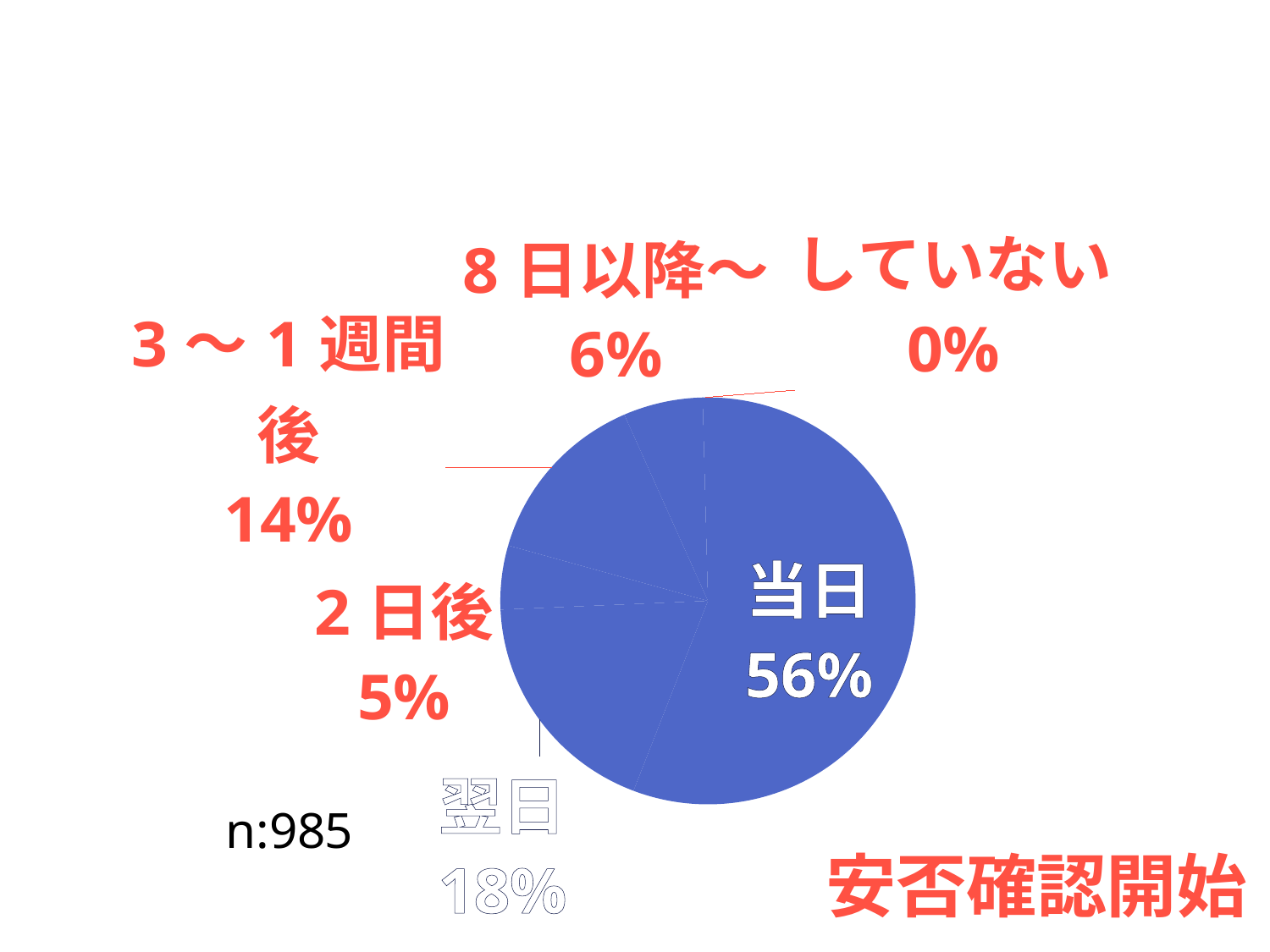
Which category has the largest share of the pie? 当日 What is the difference in percentage points between 当日 and 翌日? 38 What percentage is shown for 翌日? 18% What percentage is shown for 2日後? 5% What percentage is shown for していない? 0% What percentage is shown for 3～1週間後? 14% What percentage is shown for 8日以降～? 6% Which is larger, the share for 3～1週間後 or the share for 8日以降～? 3～1週間後 What kind of chart is shown on the slide? pie chart What percentage is shown for 当日? 56% Which category has the smallest share of the pie? していない How many categories are labelled on the pie chart? 6